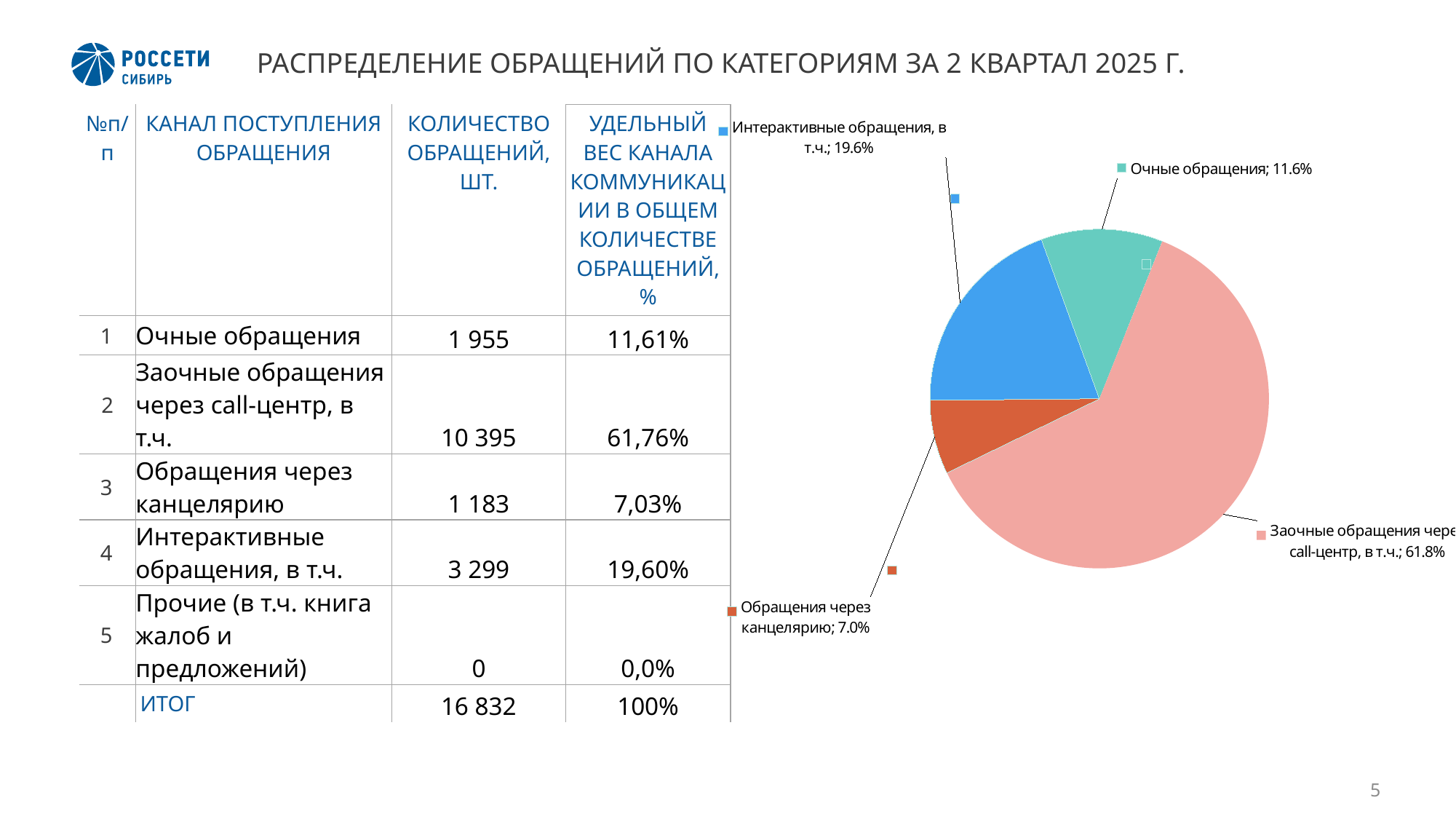
Which is larger in the pie chart: "Очные обращения" or "Интерактивные обращения, в т.ч."? Интерактивные обращения, в т.ч. What is the value shown for "Обращения через канцелярию" in the pie chart? 7.0% What is the difference in percentage points between "Очные обращения" and "Обращения через канцелярию" in the pie chart? 4.6 What share of the pie does "Заочные обращения через call-центр, в т.ч." have? 61.8% What is the difference in percentage points between "Заочные обращения через call-центр, в т.ч." and "Интерактивные обращения, в т.ч." in the pie chart? 42.2 What kind of chart is shown on the slide? pie chart What is the value shown for "Очные обращения" in the pie chart? 11.6% What share of the pie does "Интерактивные обращения, в т.ч." have? 19.6% What colour is the largest slice of the pie chart? pink How many slices does the pie chart have? 4 Which category has the smallest slice of the pie? Обращения через канцелярию Which category has the largest slice of the pie? Заочные обращения через call-центр, в т.ч.